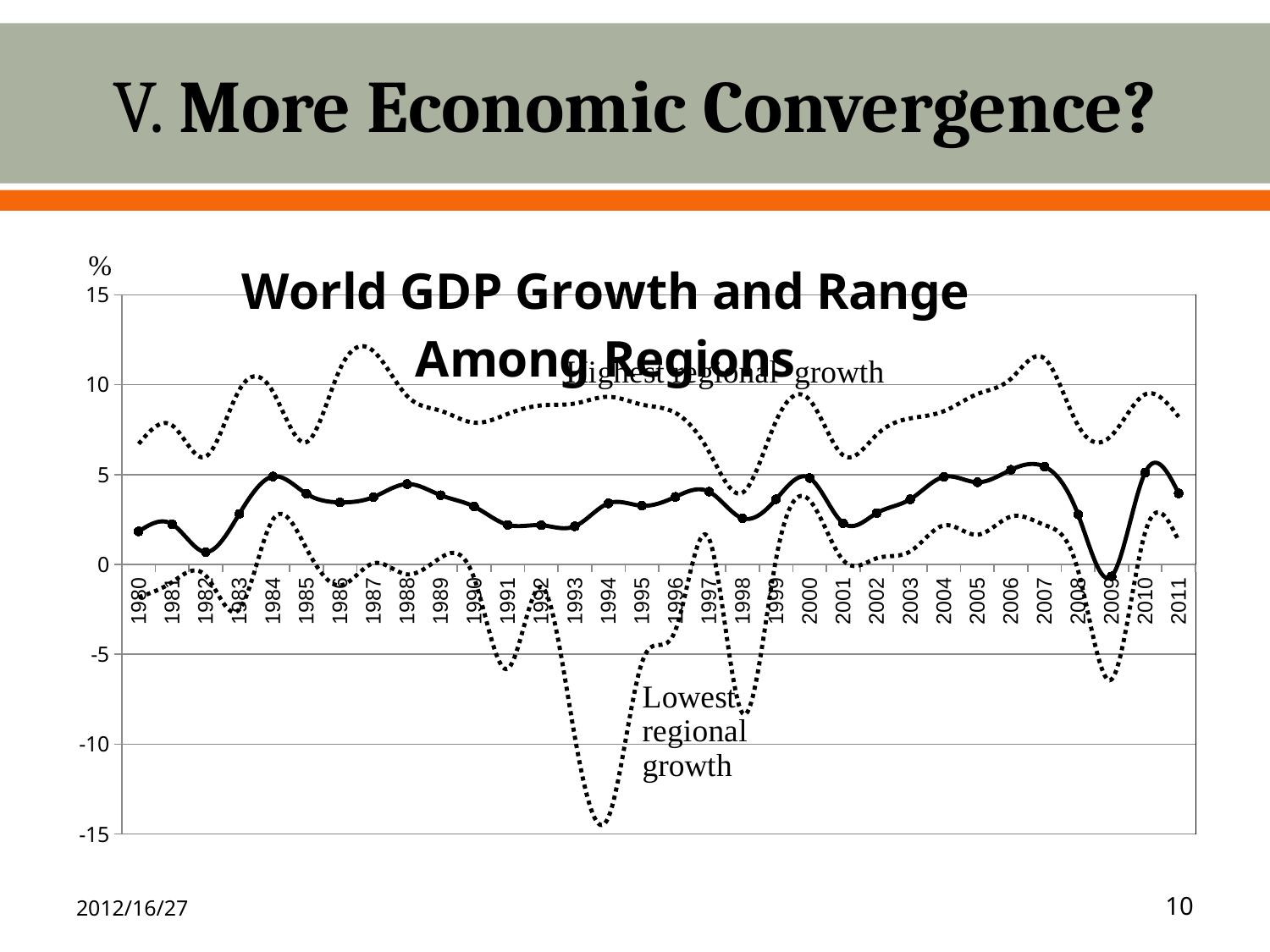
Does the world GDP growth line rise or fall from 2008 to 2009? fall What kind of chart is shown on the slide? line chart In which year does the lowest regional growth line reach its minimum? 1994 What is the title of the chart? World GDP Growth and Range Among Regions In which year does the world GDP growth line (solid line with markers) reach its lowest point? 2009 Is the world GDP growth value in 1982 greater or less than 5? less Is the world GDP growth value in 2009 greater or less than 0? less Is the value of the lowest regional growth line in 1994 greater or less than -10? less What unit is shown at the top of the vertical axis? % Which year has the larger world GDP growth value, 1982 or 1984? 1984 How many years are plotted along the x axis of the chart? 32